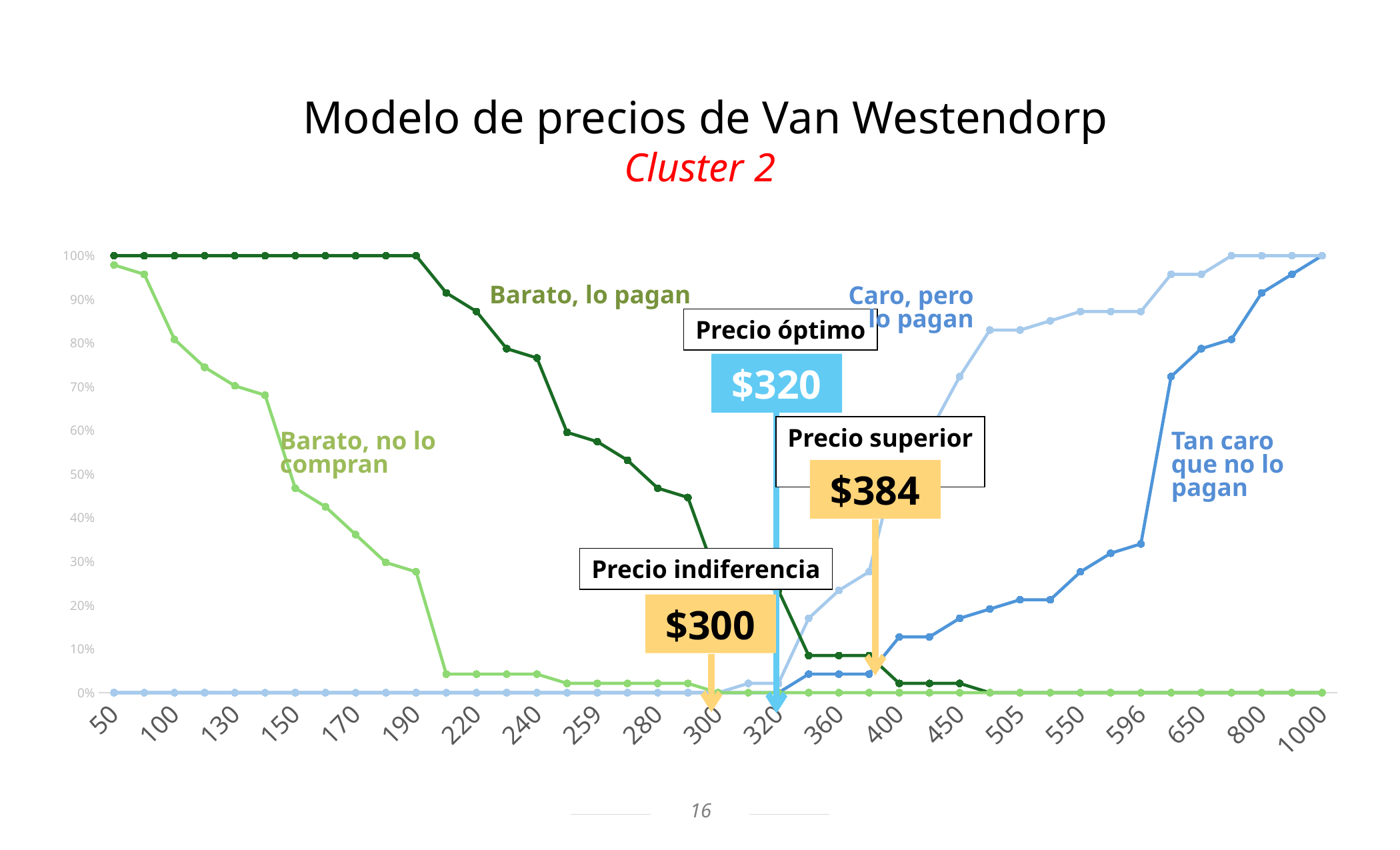
Does the 'Tan caro que no lo pagan' line rise or fall as price increases along the x axis? rise What is the value of the 'Barato, no lo compran' line at a price of 1000? 0% Is the value of the 'Barato, no lo compran' line at a price of 170 greater or less than 30%? greater What is the value of the 'Tan caro que no lo pagan' line at a price of 1000? 100% Is the value of the 'Tan caro que no lo pagan' line at a price of 450 greater or less than 20%? less Does the 'Barato, no lo compran' line rise or fall as price increases along the x axis? fall What price is labelled as the 'Precio superior' on the chart? $384 What is the value of the 'Barato, lo pagan' line at a price of 50? 100% Is the value of the 'Caro, pero lo pagan' line at a price of 505 greater or less than 80%? greater What kind of chart is shown on the slide? line chart What price is labelled as the 'Precio óptimo' on the chart? $320 What is the value of the 'Caro, pero lo pagan' line at a price of 50? 0%